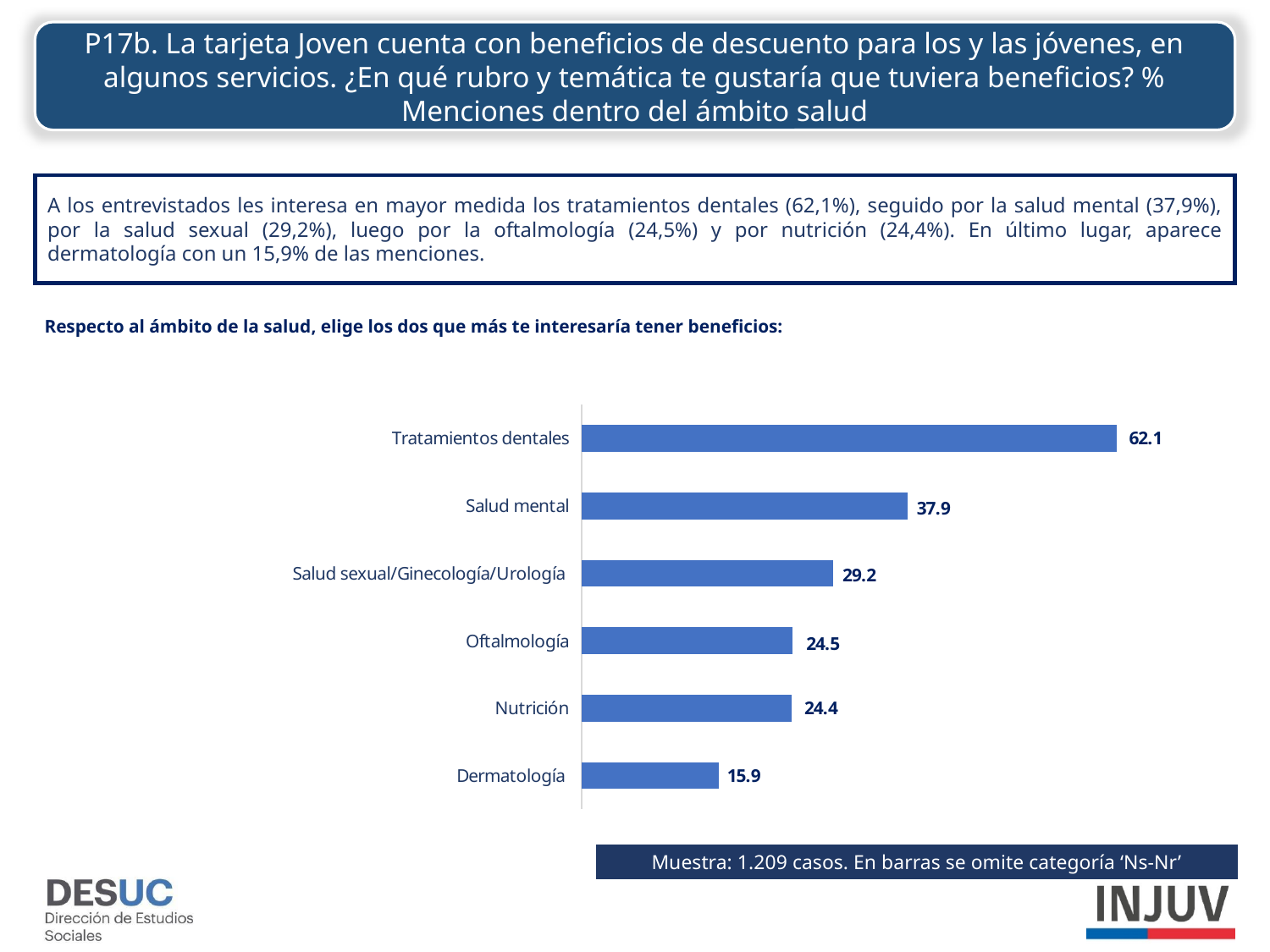
What is the value for Salud mental? 37.9 Which category has the lowest value? Dermatología What is the sample size stated on the slide? 1.209 casos What is the value for Dermatología? 15.9 What kind of chart is shown on the slide? Bar chart Which category has the highest value? Tratamientos dentales What is the value for Tratamientos dentales? 62.1 Which is larger, the value for Salud mental or the value for Salud sexual/Ginecología/Urología? Salud mental How many categories are shown in the chart? 6 What is the difference between the values for Oftalmología and Nutrición? 0.1 What is the difference between the values for Tratamientos dentales and Salud mental? 24.2 What is the value for Salud sexual/Ginecología/Urología? 29.2